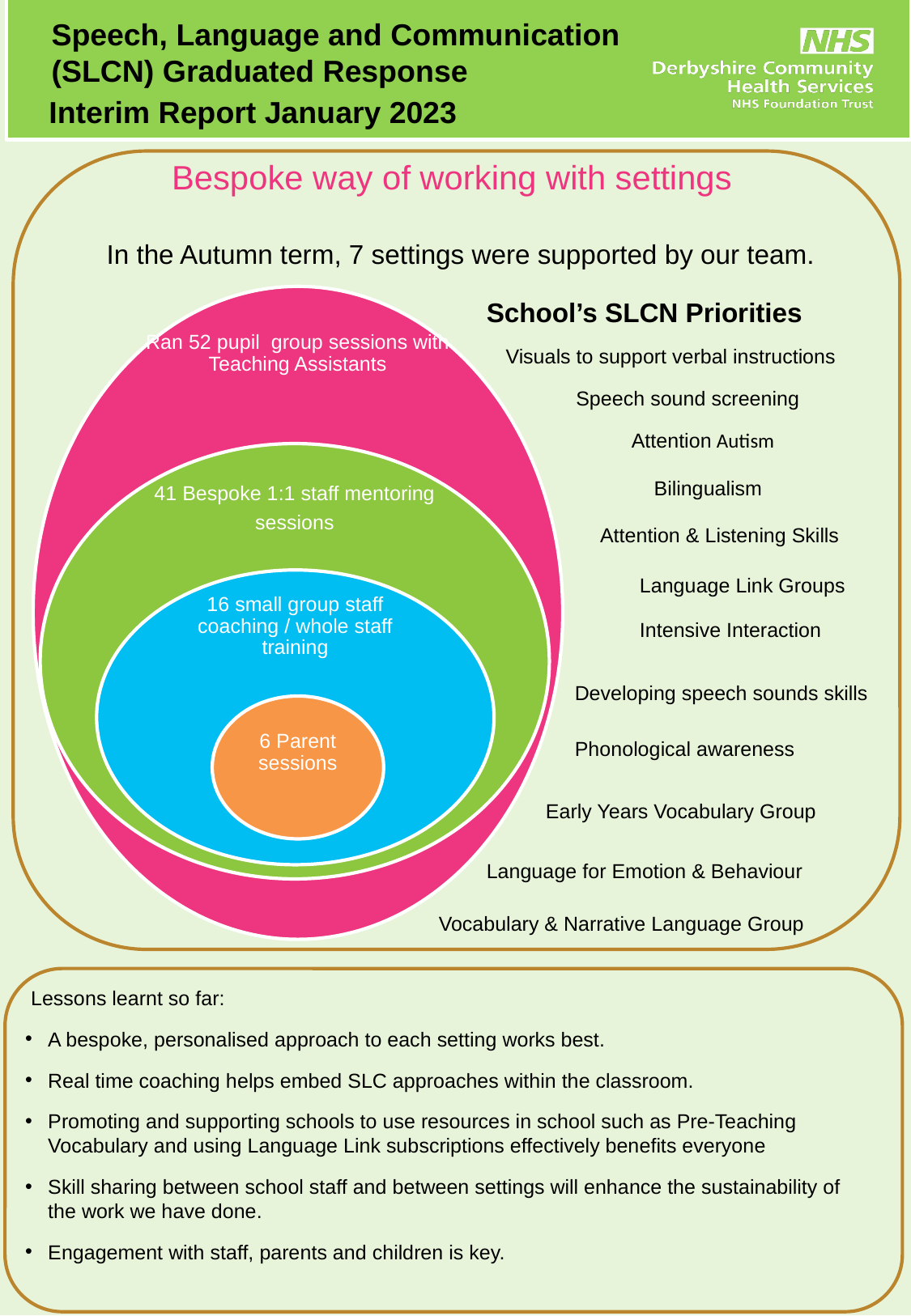
In the nested circle diagram, how many bespoke 1:1 staff mentoring sessions are shown? 41 In the nested circle diagram, how many parent sessions are shown? 6 In the nested circle diagram, which type of session has the lowest number? Parent sessions What colour is the innermost circle showing parent sessions? Orange In the nested circle diagram, how many small group staff coaching / whole staff training sessions are shown? 16 In the nested circle diagram, how many pupil group sessions were run with Teaching Assistants? 52 In the nested circle diagram, what is the difference between the number of pupil group sessions and the number of bespoke 1:1 staff mentoring sessions? 11 In the nested circle diagram, what is the difference between the number of small group staff coaching sessions and the number of parent sessions? 10 In the nested circle diagram, which is larger: the number of bespoke 1:1 staff mentoring sessions or the number of small group staff coaching sessions? Bespoke 1:1 staff mentoring sessions In the nested circle diagram, which type of session has the highest number? Pupil group sessions with Teaching Assistants What colour is the outermost circle showing pupil group sessions with Teaching Assistants? Pink How many nested circles (session categories) does the diagram contain? 4